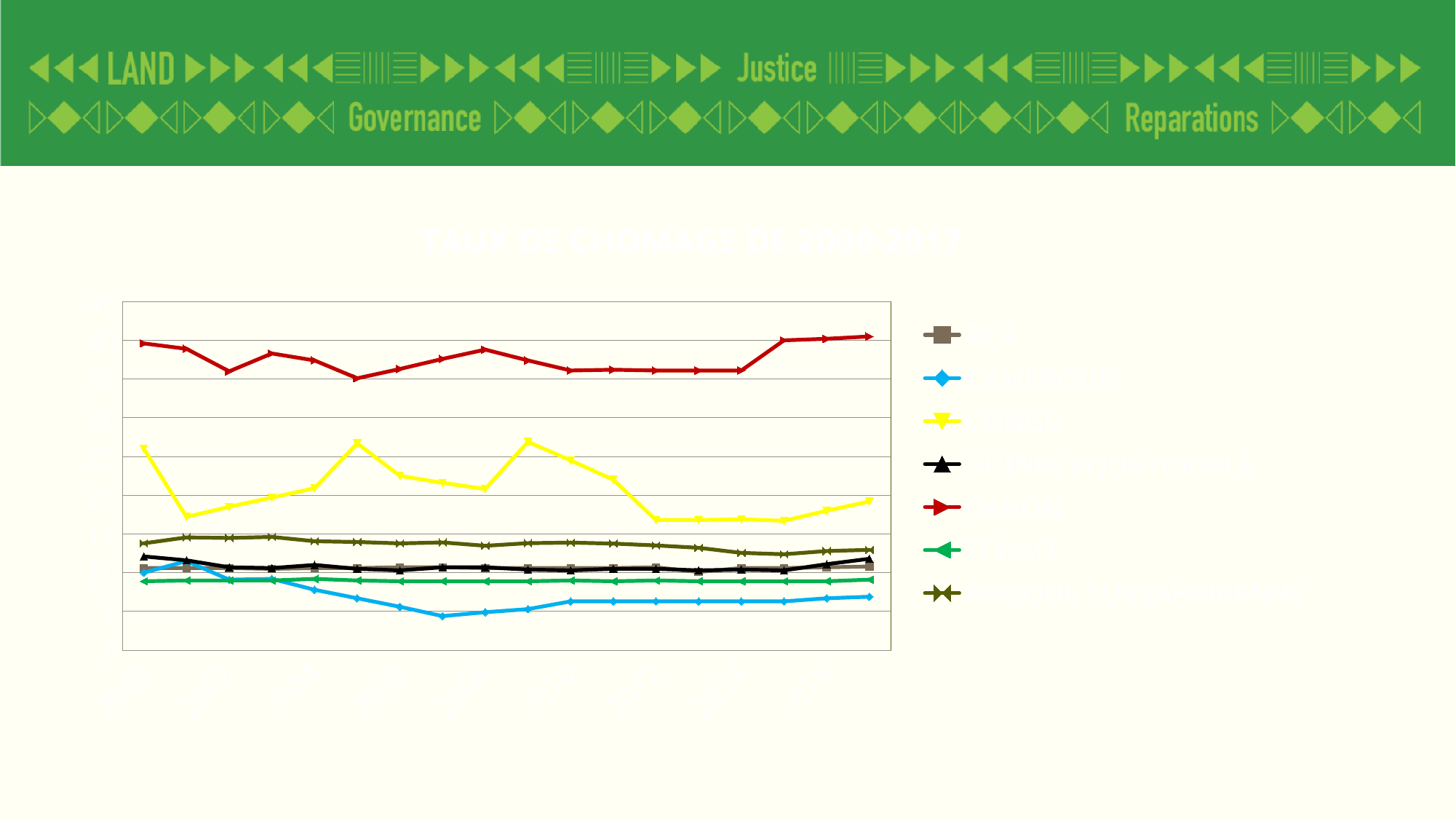
Which coloured line has the lowest values across the chart? blue How many data points does each line have along the x axis? 18 Which line is higher, the dark olive line with x markers or the black line with triangle markers? dark olive Which line is higher, the yellow line or the green line? yellow Which line is higher, the red line or the yellow line? red Does the blue line rise or fall between its second and sixth points? fall What kind of chart is shown on the slide? line chart How many series does the legend list? 7 Which coloured line has the highest values across the chart? red Does the red line rise or fall over its last three points? rise